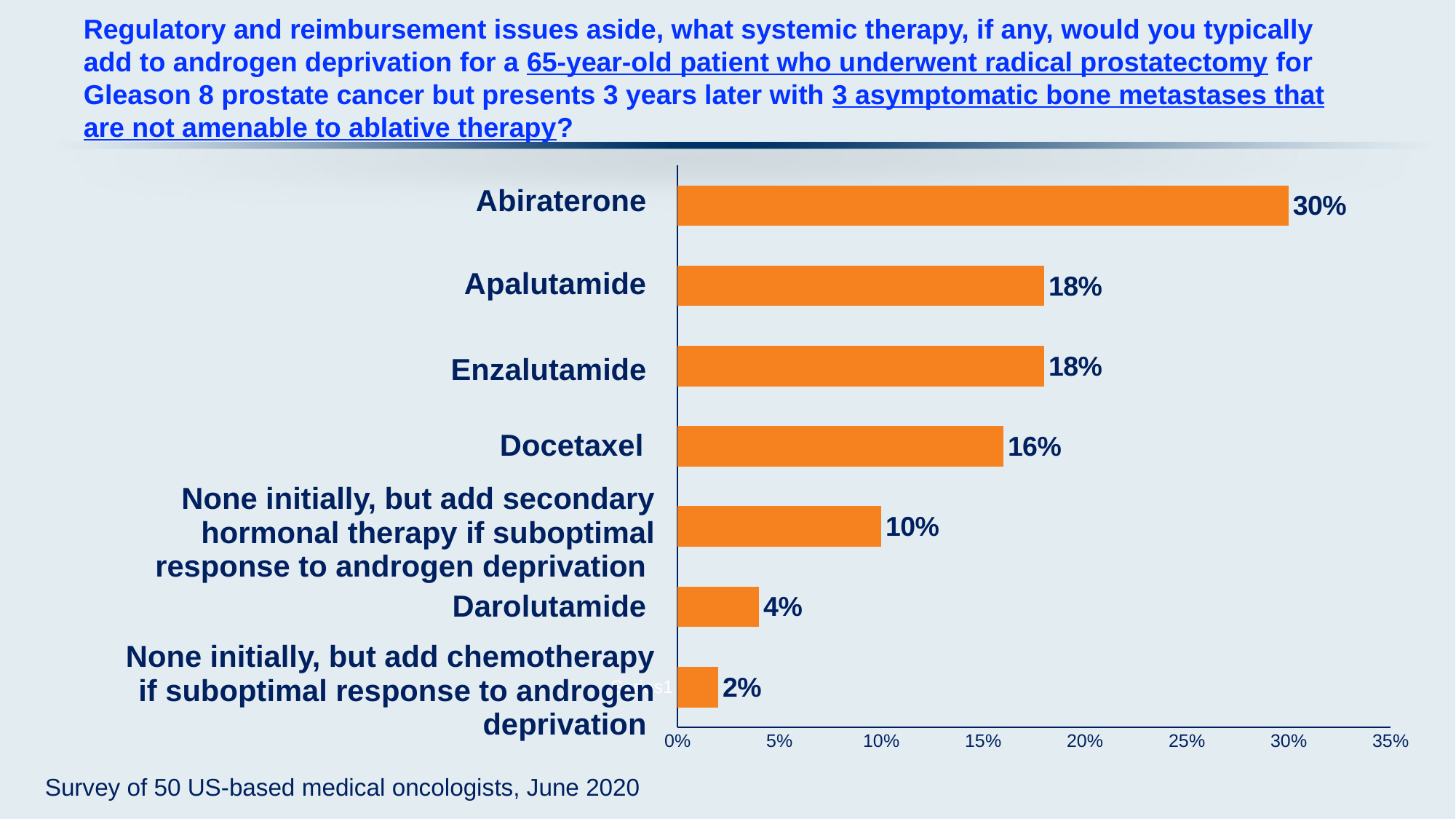
What percentage is shown for Darolutamide? 4% Which option has the lowest percentage? None initially, but add chemotherapy if suboptimal response to androgen deprivation What is the difference between the percentages for Abiraterone and Apalutamide? 12% Which has a larger value, Docetaxel or Darolutamide? Docetaxel How many therapy options are shown in the chart? 7 Is the value for Enzalutamide greater or less than 15%? greater What is the value shown for Docetaxel? 16% Which therapy option has the highest percentage? Abiraterone What is the value for 'None initially, but add chemotherapy if suboptimal response to androgen deprivation'? 2% What type of chart is shown on the slide? Bar chart How many oncologists were surveyed according to the note at the bottom of the slide? 50 What percentage of respondents chose Abiraterone? 30%